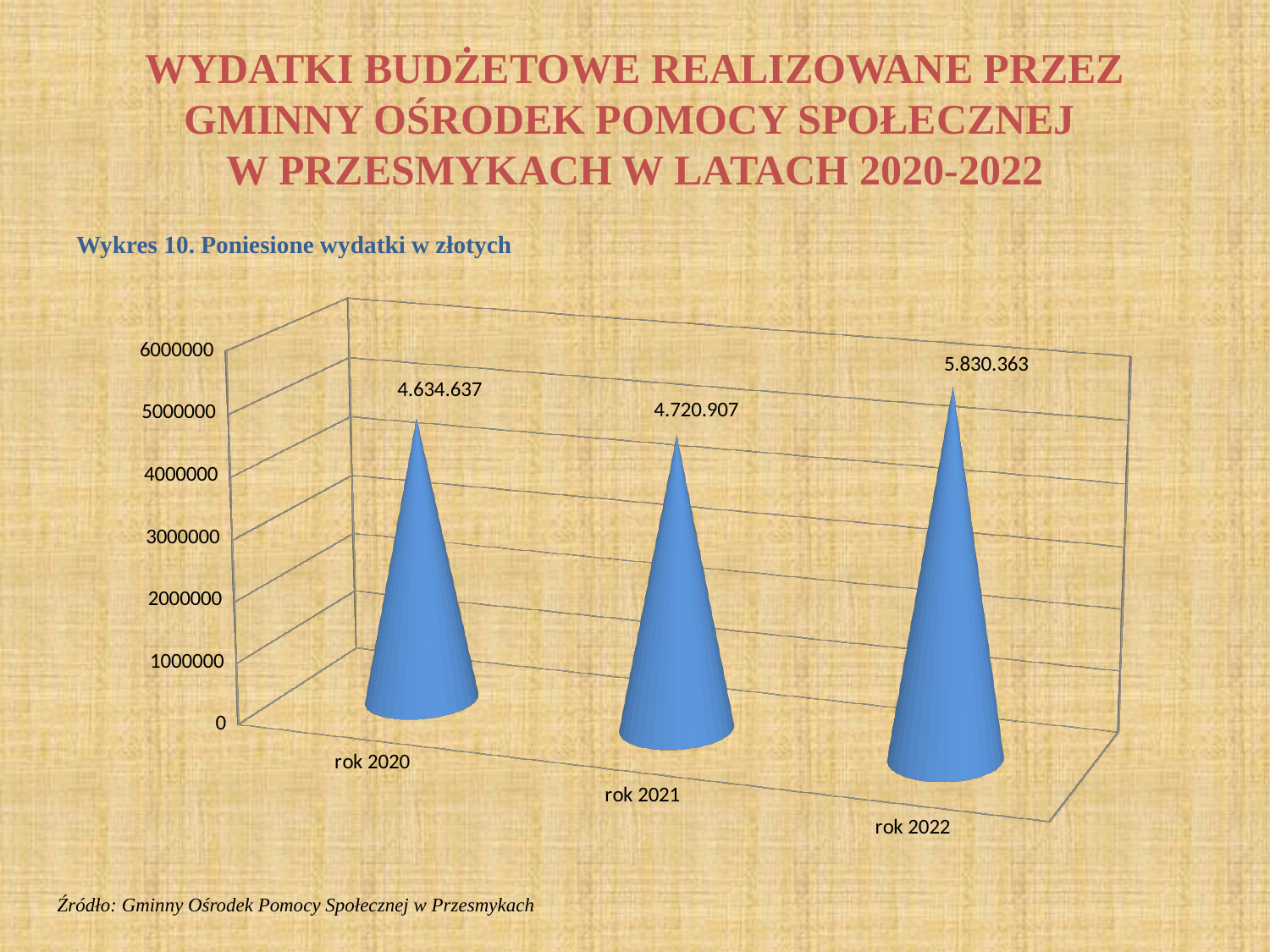
What is the value for rok 2021? 4.720.907 What is the difference between the values for rok 2021 and rok 2020? 86.270 What is the title of the chart (Wykres 10)? Poniesione wydatki w złotych Which year has the highest expenditure? rok 2022 How many years are shown on the chart? 3 What is the value for rok 2020? 4.634.637 Is the value for rok 2022 greater or less than 5000000? greater Which is larger, the value for rok 2022 or the value for rok 2020? rok 2022 Do the values rise or fall from rok 2020 to rok 2022? rise What is the value for rok 2022? 5.830.363 What is the difference between the values for rok 2022 and rok 2021? 1.109.456 Which year has the lowest expenditure? rok 2020